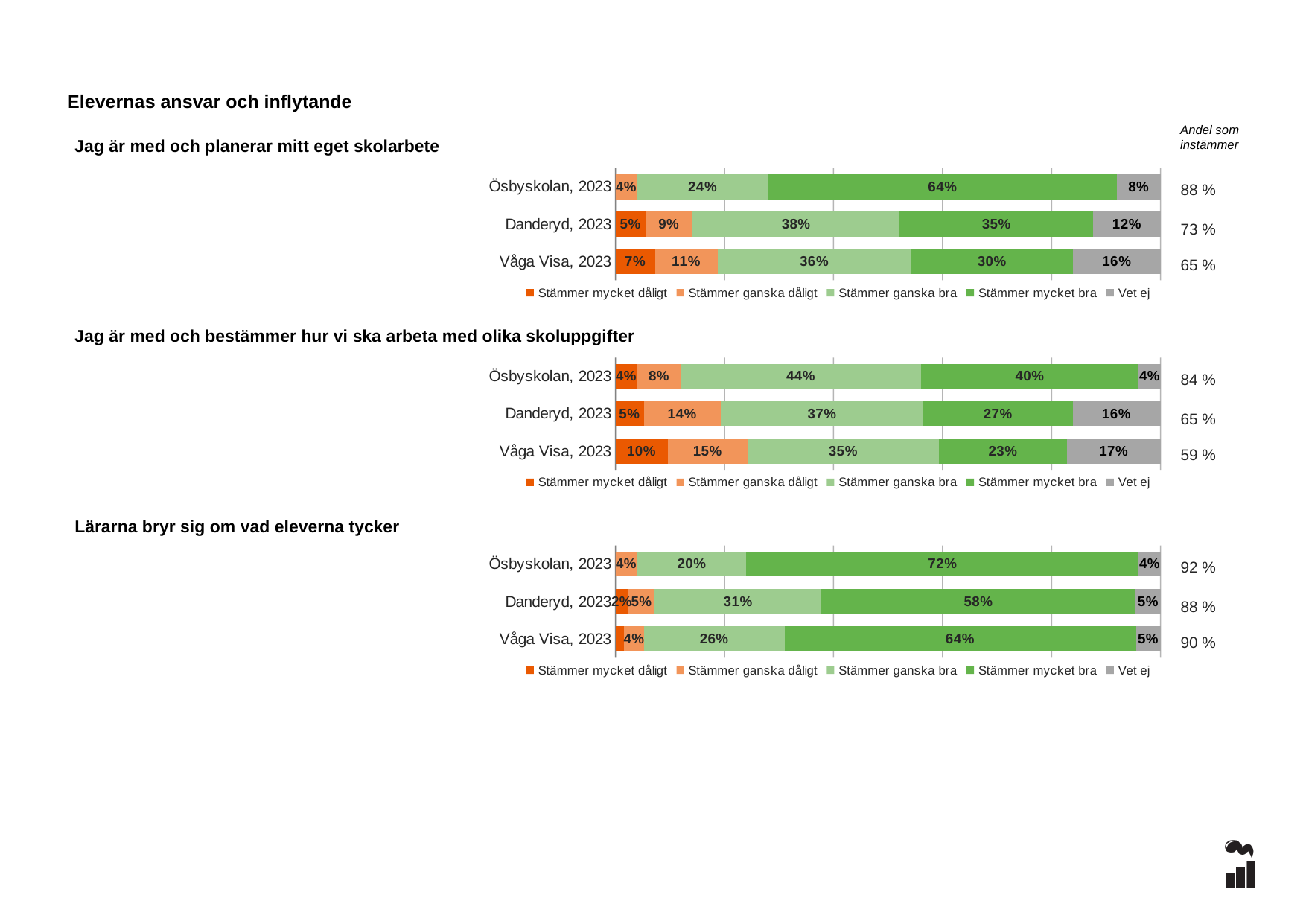
In the chart 'Jag är med och planerar mitt eget skolarbete', what is the 'Stämmer mycket bra' value for Ösbyskolan, 2023? 64% How many series does the legend list in the chart 'Jag är med och planerar mitt eget skolarbete'? 5 In the chart 'Lärarna bryr sig om vad eleverna tycker', what is the 'Andel som instämmer' value for Ösbyskolan, 2023? 92 % In the chart 'Jag är med och planerar mitt eget skolarbete', which row has the highest 'Stämmer mycket bra' value? Ösbyskolan, 2023 In the chart 'Lärarna bryr sig om vad eleverna tycker', which is larger: the 'Stämmer ganska bra' value for Danderyd, 2023 or for Våga Visa, 2023? Danderyd, 2023 In the chart 'Jag är med och bestämmer hur vi ska arbeta med olika skoluppgifter', what is the 'Stämmer ganska bra' value for Danderyd, 2023? 37% In the chart 'Jag är med och bestämmer hur vi ska arbeta med olika skoluppgifter', which row has the highest 'Stämmer mycket dåligt' value? Våga Visa, 2023 In the chart 'Lärarna bryr sig om vad eleverna tycker', what is the 'Stämmer mycket bra' value for Danderyd, 2023? 58% In the chart 'Jag är med och planerar mitt eget skolarbete', what is the 'Vet ej' value for Våga Visa, 2023? 16% What kind of chart is 'Jag är med och bestämmer hur vi ska arbeta med olika skoluppgifter'? Stacked bar chart In the chart 'Jag är med och bestämmer hur vi ska arbeta med olika skoluppgifter', what is the difference between the 'Stämmer mycket bra' values for Ösbyskolan, 2023 and Våga Visa, 2023? 17% How many rows (categories) are shown in the chart 'Lärarna bryr sig om vad eleverna tycker'? 3